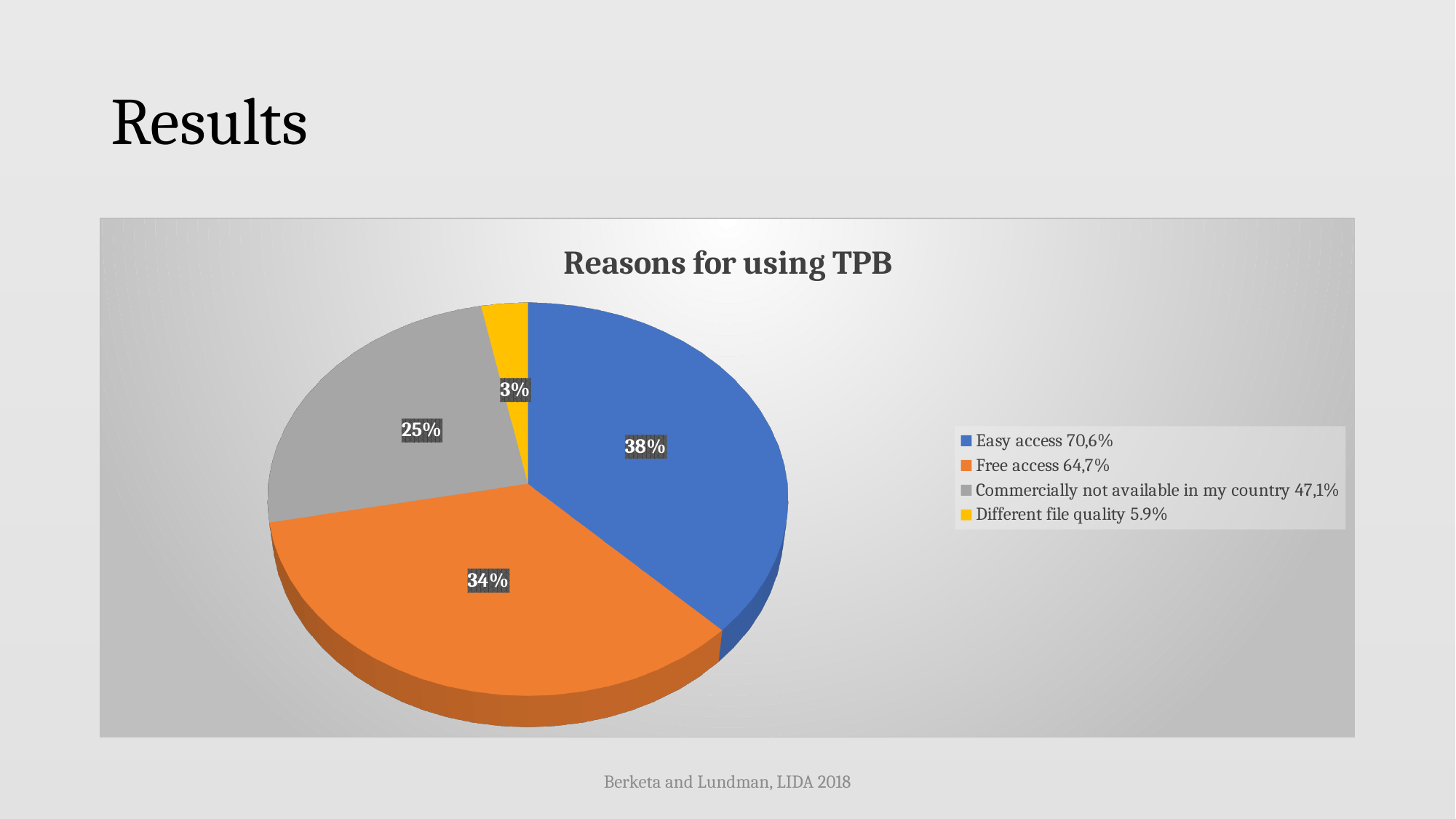
What share of the pie does the Easy access slice represent? 38% What kind of chart is shown on the slide? pie chart What share of the pie does the Free access slice represent? 34% What is the title of the chart? Reasons for using TPB What is the difference in percentage points between the Easy access slice and the Free access slice? 4 What share of the pie does the Different file quality slice represent? 3% How many slices does the pie chart have? 4 Which slice is larger, Commercially not available in my country or Different file quality? Commercially not available in my country Which reason has the smallest slice of the pie? Different file quality What colour is the Free access slice? orange Which reason has the largest slice of the pie? Easy access